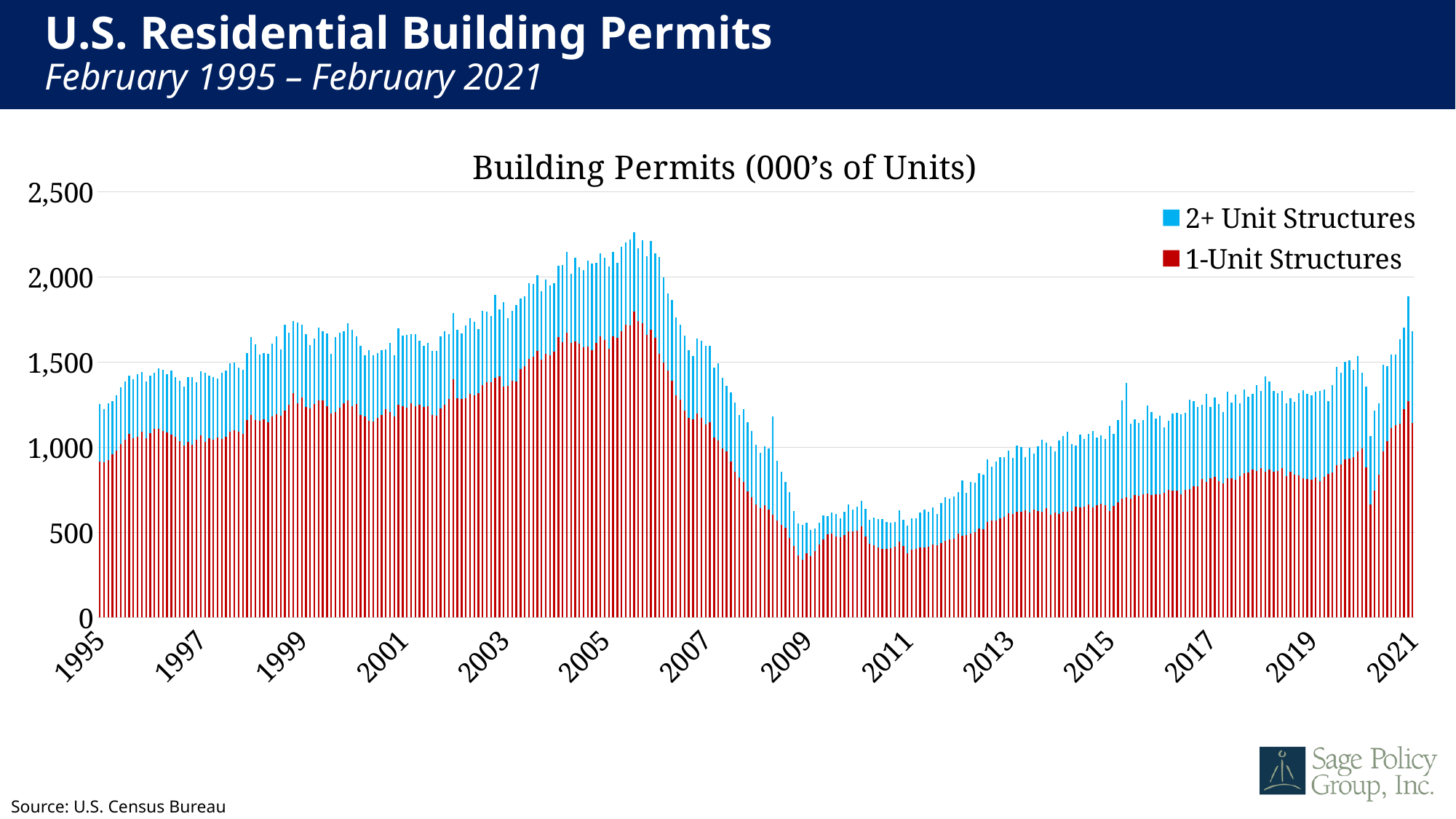
Which series accounts for the larger share of permits in 2005, 1-Unit Structures or 2+ Unit Structures? 1-Unit Structures What are the two series named in the legend? 2+ Unit Structures and 1-Unit Structures What kind of chart is shown on the slide? Stacked bar chart How many series does the chart's legend list? 2 Do total building permits rise or fall between 2006 and 2009? fall Is the 1-Unit Structures value in early 2009 greater or less than 500? less Do total building permits rise or fall between 2011 and 2019? rise Is the total building permits value around 2005 greater or less than 2,000? greater What is the title of the chart? Building Permits (000's of Units) Which year has higher total building permits, 2005 or 2009? 2005 Is the total building permits value around 2009 greater or less than 1,000? less